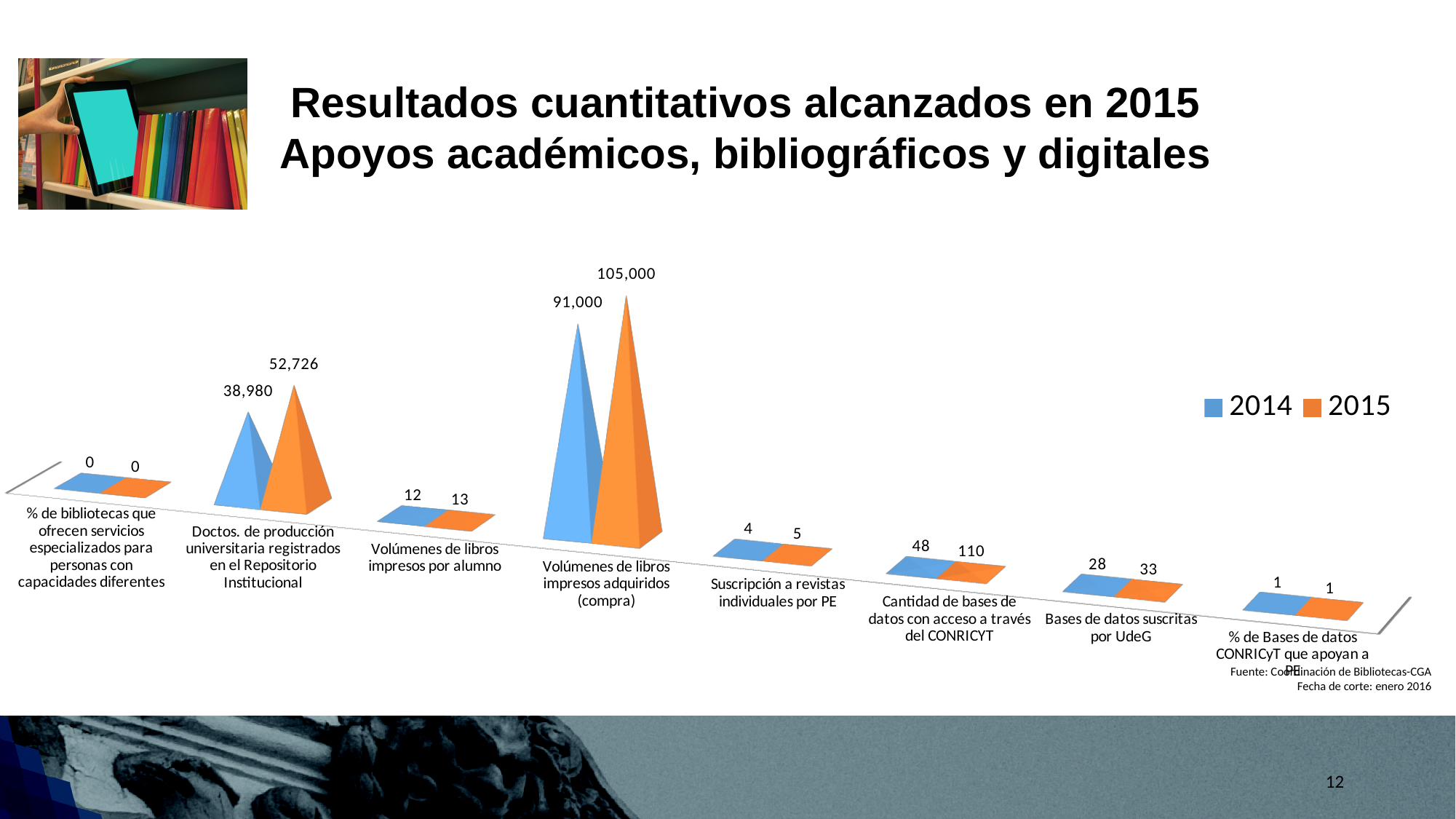
What is the 2014 value for "Doctos. de producción universitaria registrados en el Repositorio Institucional"? 38,980 What is the 2015 value for "Volúmenes de libros impresos adquiridos (compra)"? 105,000 Which is larger for "Cantidad de bases de datos con acceso a través del CONRICYT": the 2014 value or the 2015 value? 2015 How many series does the chart legend list? 2 What kind of chart is shown on the slide? Bar chart How many categories are shown on the x axis of the chart? 8 What is the difference between the 2015 and 2014 values for "Volúmenes de libros impresos adquiridos (compra)"? 14,000 Which series is shown in orange in the chart legend? 2015 What is the 2014 value for "Bases de datos suscritas por UdeG"? 28 What is the 2015 value for "Cantidad de bases de datos con acceso a través del CONRICYT"? 110 Which category has the highest 2015 value? Volúmenes de libros impresos adquiridos (compra) What is the difference between the 2015 and 2014 values for "Doctos. de producción universitaria registrados en el Repositorio Institucional"? 13,746